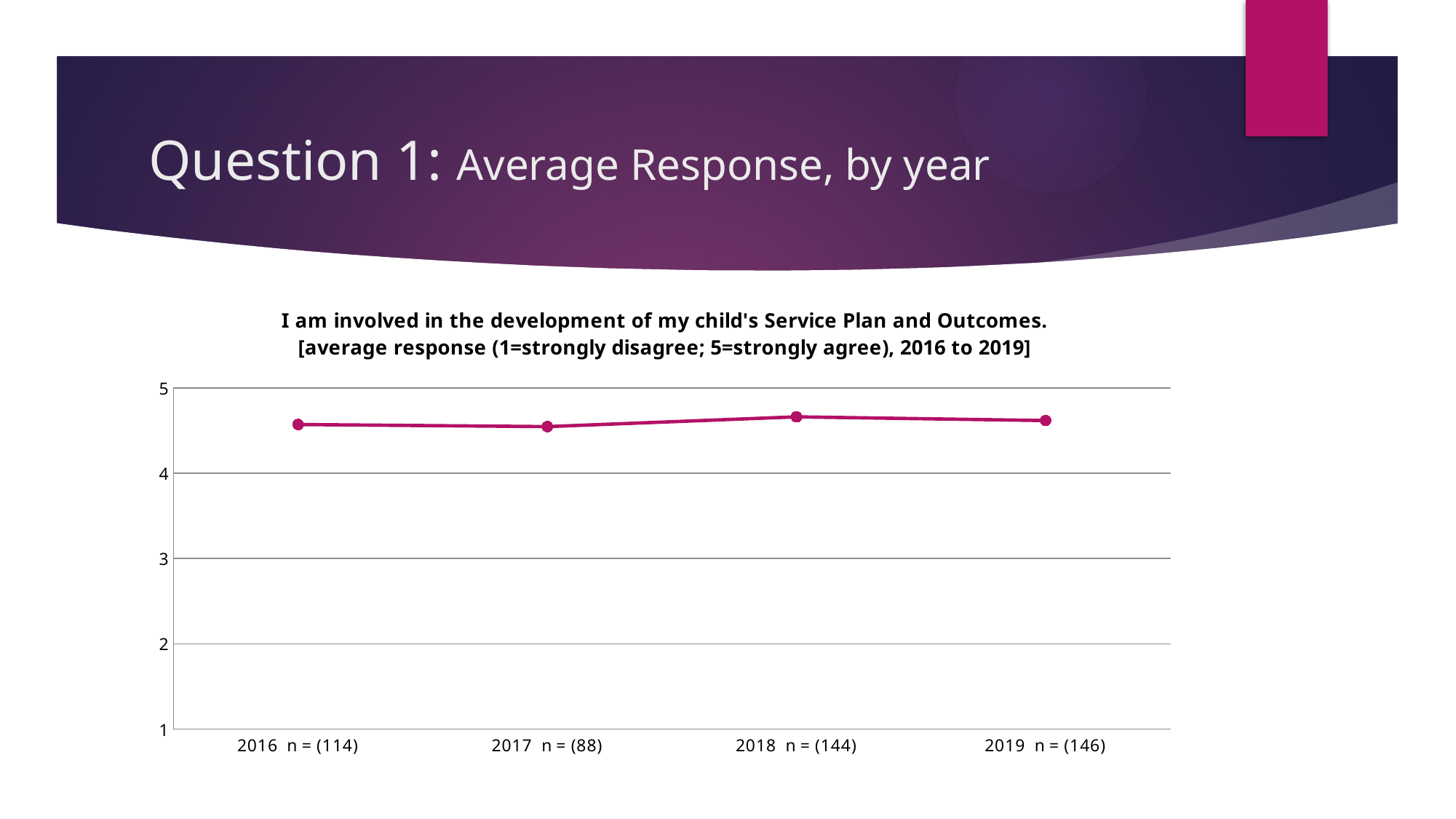
What is the sample size (n) shown for 2019? 146 Is the average response for 2018 greater or less than 5? less How many years (data points) are plotted on the chart? 4 Is the average response for 2016 greater or less than 4? greater What is the lowest value shown on the vertical axis? 1 What is the sample size (n) shown for 2017? 88 Is the average response for 2017 greater or less than 4? greater What kind of chart is shown on the slide? line chart Does the average response rise or fall from 2017 to 2018? rise